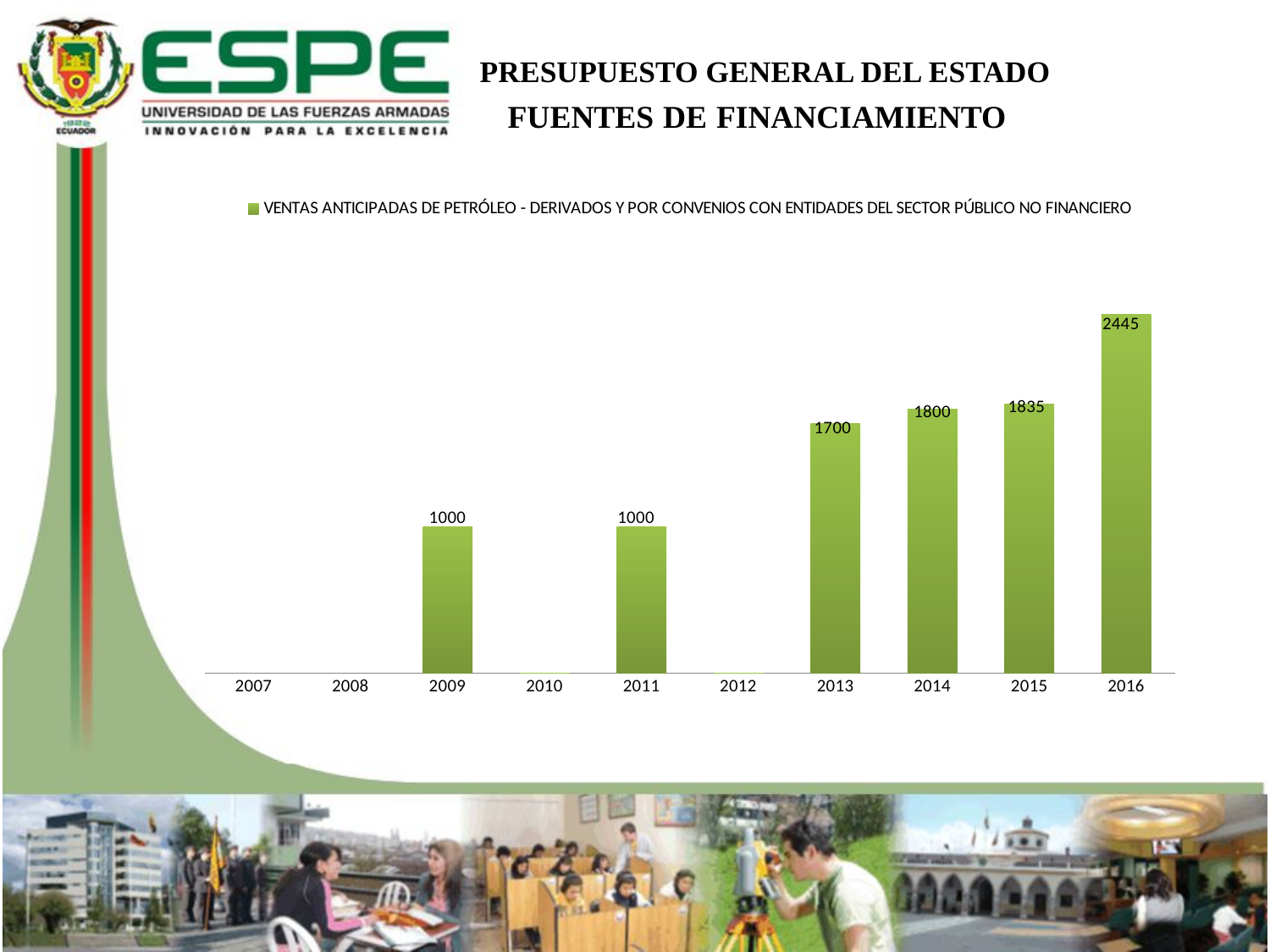
What is the difference between the values for 2014 and 2013? 100 What is the value for 2009? 1000 What is the value for 2013? 1700 Which year has the highest value? 2016 What is the value for 2016? 2445 What is the difference between the values for 2016 and 2015? 610 What kind of chart is shown on the slide? Bar chart What is the value for 2015? 1835 How many years are shown on the x axis? 10 How many series does the legend list? 1 Which is larger, the value for 2014 or the value for 2011? 2014 How many bars are plotted on the chart? 6